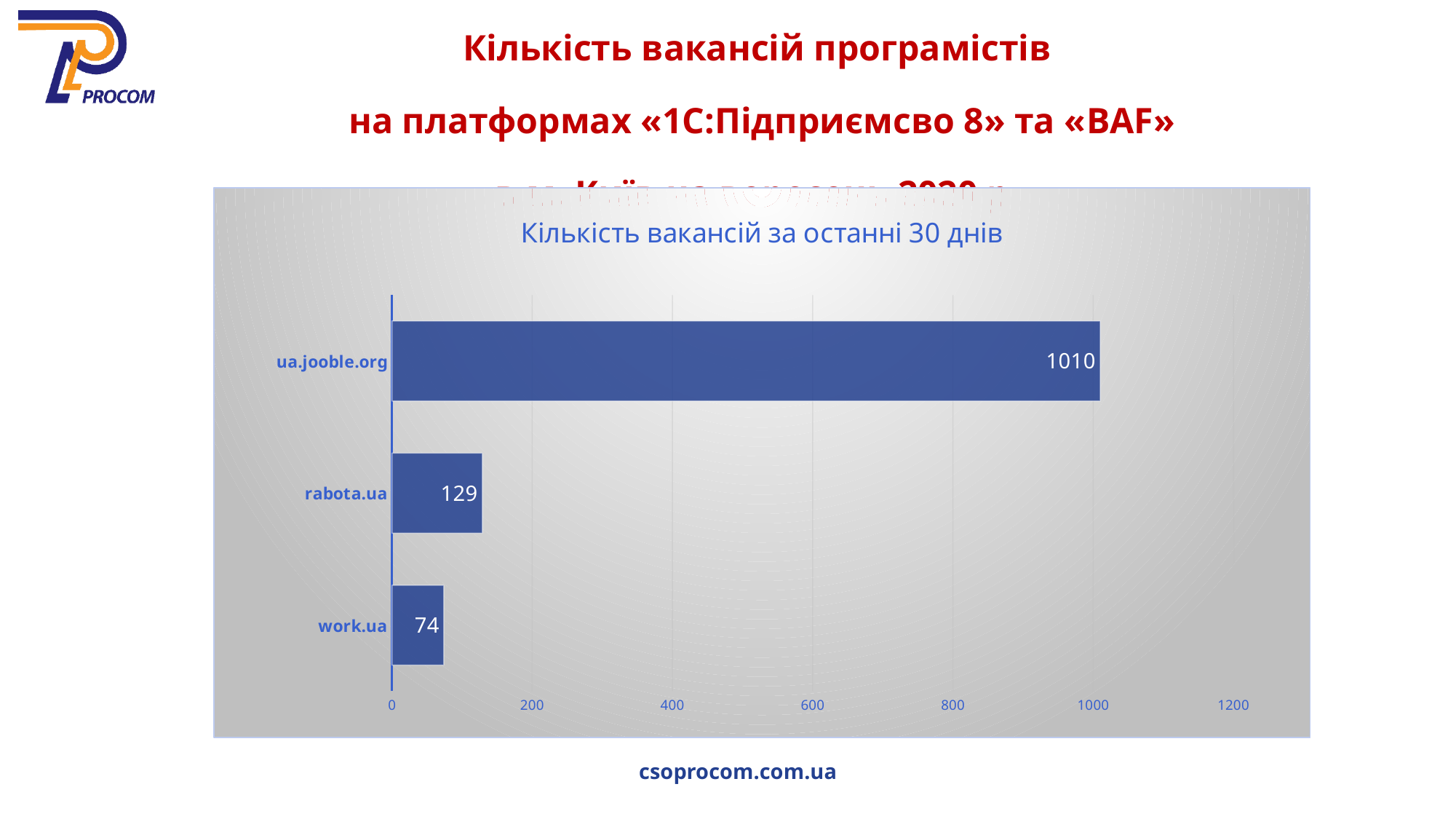
What is the title of the chart? Кількість вакансій за останні 30 днів Which category has the lowest value? work.ua What is the difference between the values for ua.jooble.org and rabota.ua? 881 What is the value for work.ua? 74 What is the value for ua.jooble.org? 1010 Is the value for ua.jooble.org greater or less than 800? greater What is the value for rabota.ua? 129 Which category has the highest value? ua.jooble.org What kind of chart is shown on the slide? bar chart How many categories are shown in the chart? 3 What is the difference between the values for rabota.ua and work.ua? 55 Which is larger, the value for rabota.ua or the value for work.ua? rabota.ua